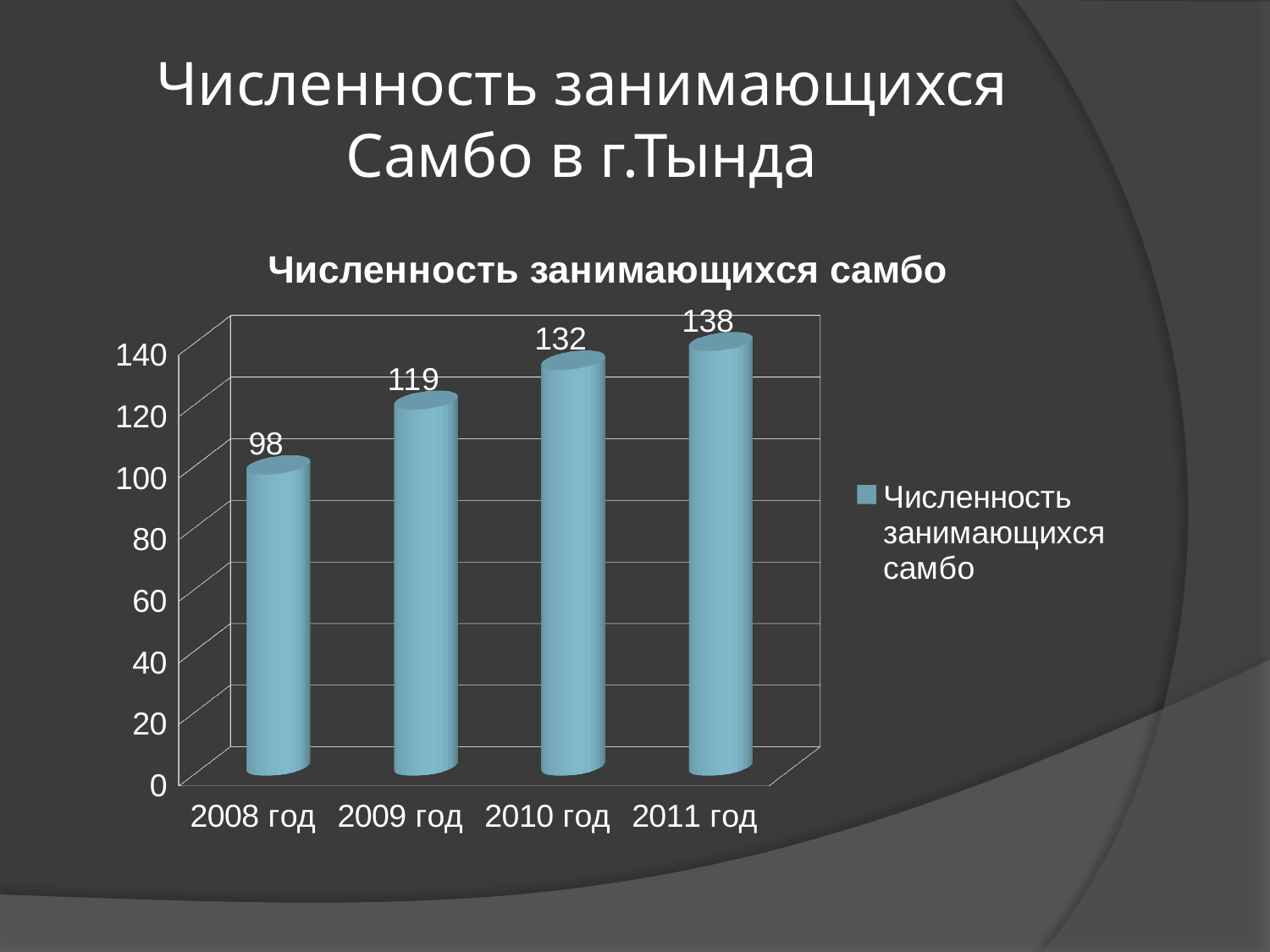
What is the value for 2008 год? 98 How many series does the legend list? 1 What is the value for 2010 год? 132 Which year has the highest value? 2011 год What is the value for 2011 год? 138 What kind of chart is shown? bar chart How many years are shown on the x axis? 4 Which year has the lowest value? 2008 год Which is larger, the value for 2009 год or the value for 2010 год? 2010 год What is the difference between the values for 2009 год and 2008 год? 21 Do the values rise or fall from 2008 год to 2011 год? rise What is the difference between the values for 2011 год and 2008 год? 40